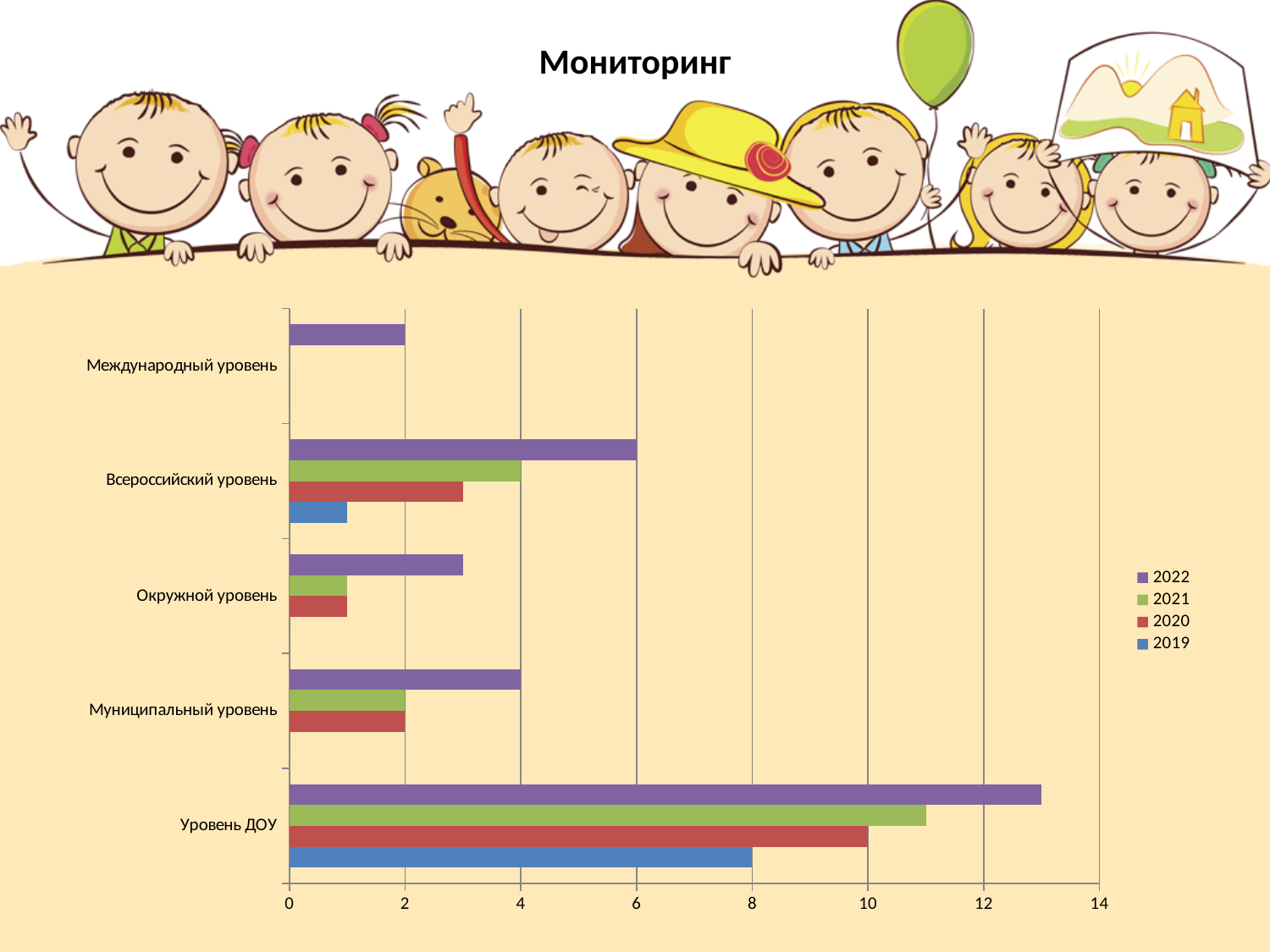
What kind of chart is shown on the slide? bar chart How many categories are shown on the chart? 5 What is the value for Уровень ДОУ in the 2020 series? 10 What is the value for Международный уровень in the 2022 series? 2 Which category has the lowest value in the 2022 series? Международный уровень What is the difference between the 2022 and 2021 values for Всероссийский уровень? 2 What is the value for Муниципальный уровень in the 2022 series? 4 What is the value for Уровень ДОУ in the 2019 series? 8 What is the value for Всероссийский уровень in the 2022 series? 6 Is the value for Уровень ДОУ in the 2022 series greater or less than 12? greater Which category has the highest value in the 2022 series? Уровень ДОУ How many series does the legend list? 4